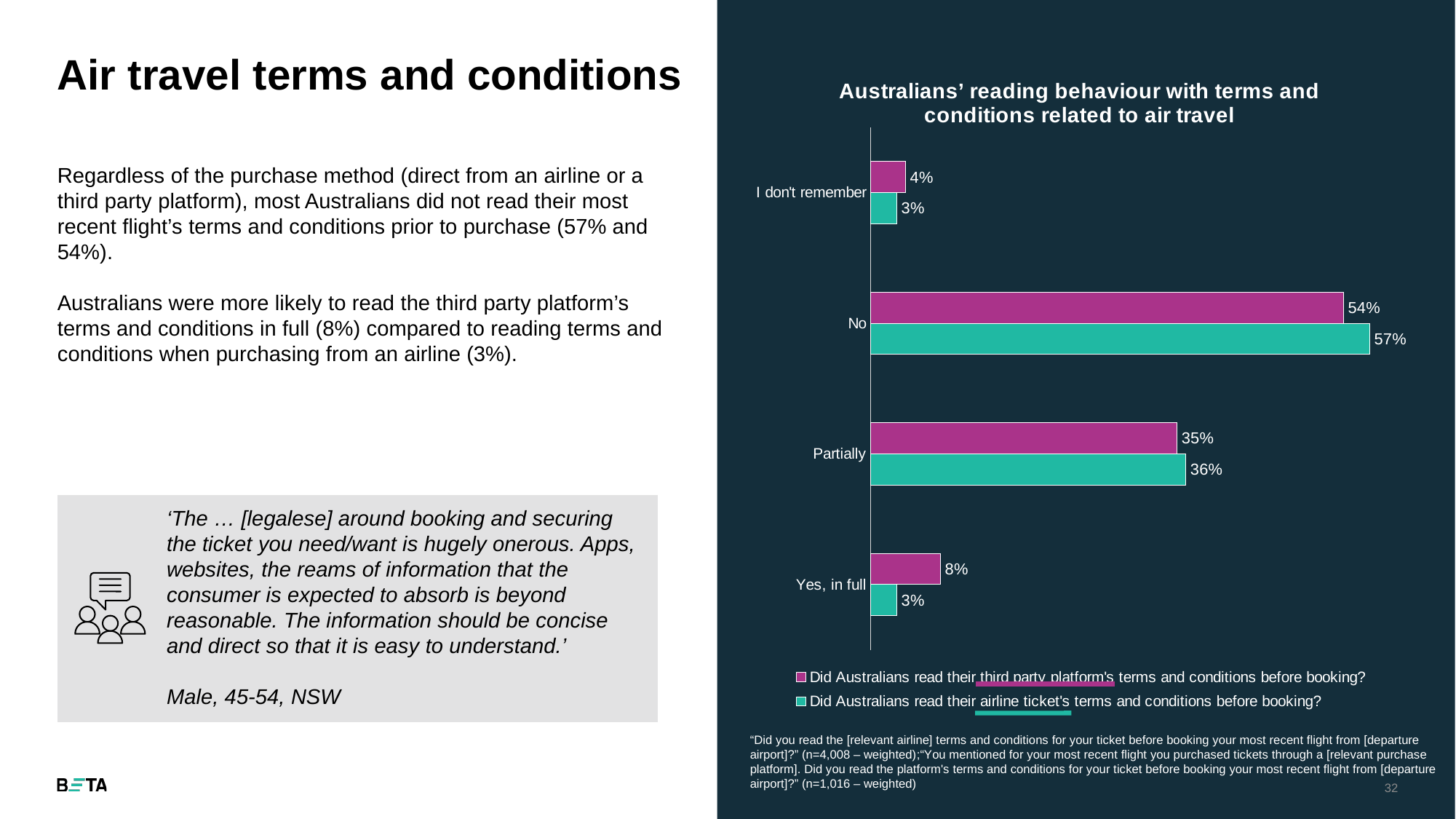
What percentage of Australians partially read their airline ticket's terms and conditions before booking? 36% What percentage of Australians read their third party platform's terms and conditions in full before booking? 8% For the 'No' category, which series has the larger value: third party platform or airline ticket? Airline ticket What type of chart is shown on the slide? Bar chart Which category has the lowest value for the airline ticket series? I don't remember and Yes, in full (both 3%) Which category has the highest value for the third party platform series? No What percentage of Australians said 'No' to reading their airline ticket's terms and conditions before booking? 57% How many series does the legend list? 2 What is the title of the chart? Australians' reading behaviour with terms and conditions related to air travel What is the difference between the 'Yes, in full' values for the third party platform series and the airline ticket series? 5 percentage points Which colour represents the series about airline ticket's terms and conditions? Teal (green) How many response categories are shown on the chart? 4